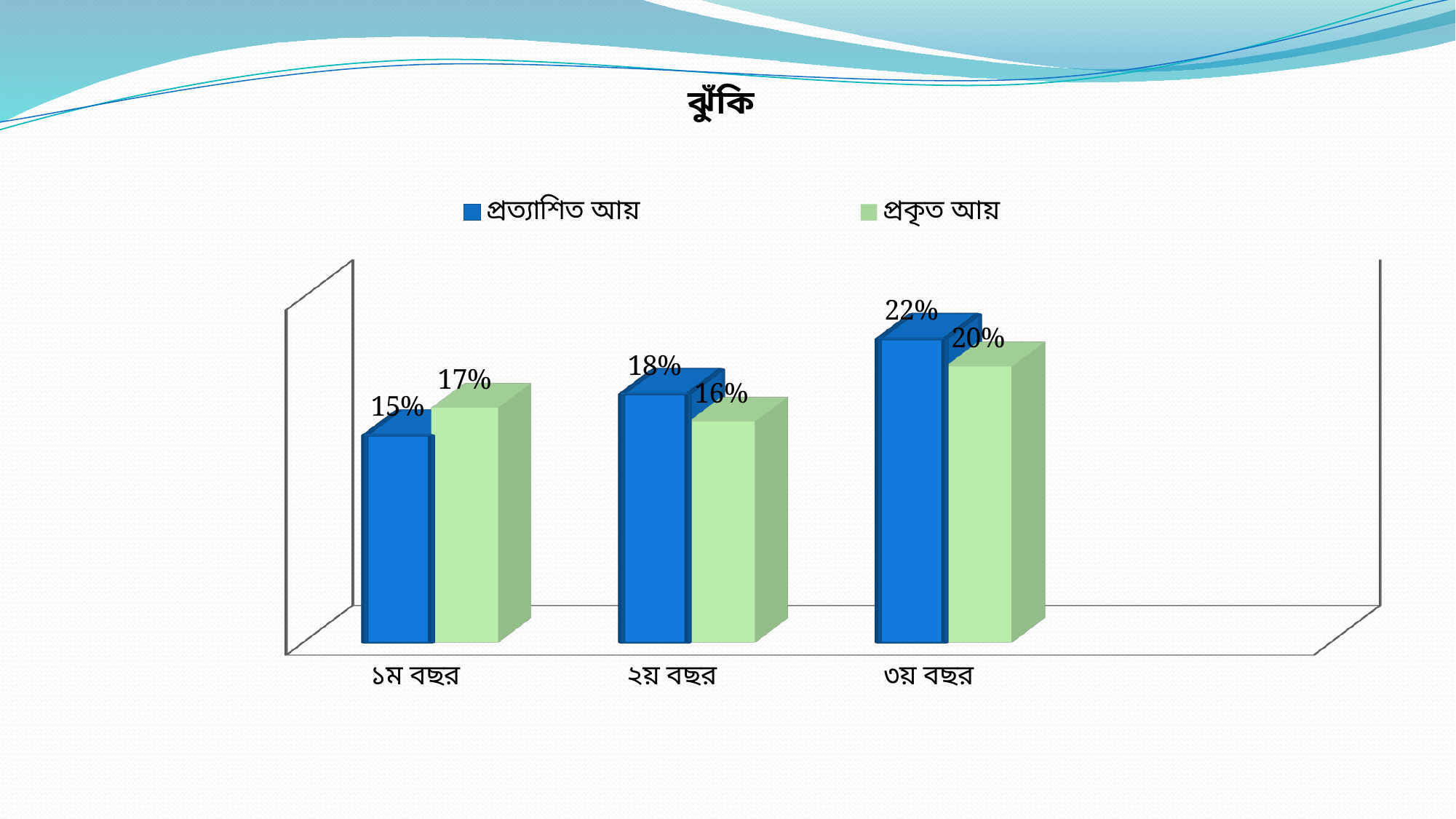
Does প্রত্যাশিত আয় rise or fall from ১ম বছর to ৩য় বছর? Rise Which year has the lowest value for প্রকৃত আয়? ২য় বছর What kind of chart is shown on the slide? Bar chart What is the value of প্রকৃত আয় for ৩য় বছর? 20% Which year has the highest value for প্রত্যাশিত আয়? ৩য় বছর For ১ম বছর, which is larger: প্রত্যাশিত আয় or প্রকৃত আয়? প্রকৃত আয় What is the value of প্রকৃত আয় for ২য় বছর? 16% What is the difference between প্রত্যাশিত আয় and প্রকৃত আয় for ৩য় বছর? 2% What is the value of প্রত্যাশিত আয় for ১ম বছর? 15% How many year categories are shown on the x axis? 3 How many series does the legend list? 2 What is the title of the slide? ঝুঁকি